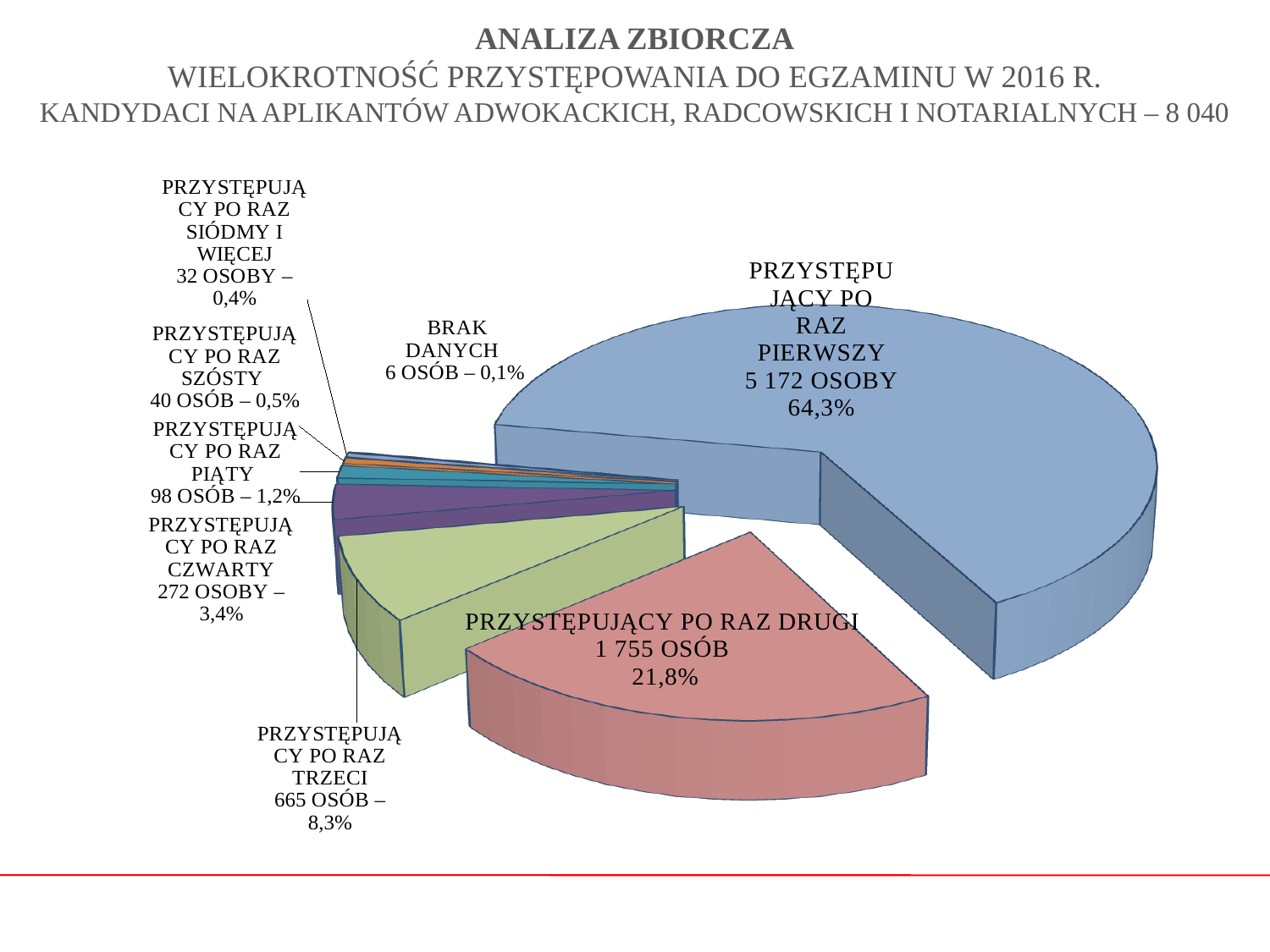
What share of the pie does 'PRZYSTĘPUJĄCY PO RAZ DRUGI' represent? 21,8% Which category has the largest slice of the pie? PRZYSTĘPUJĄCY PO RAZ PIERWSZY How many people are in the 'PRZYSTĘPUJĄCY PO RAZ SIÓDMY I WIĘCEJ' slice? 32 OSOBY Which is larger: the 'PRZYSTĘPUJĄCY PO RAZ PIĄTY' slice or the 'PRZYSTĘPUJĄCY PO RAZ SZÓSTY' slice? PRZYSTĘPUJĄCY PO RAZ PIĄTY How many people are in the 'PRZYSTĘPUJĄCY PO RAZ TRZECI' slice? 665 OSÓB What kind of chart is shown on the slide? pie chart What total number of candidates is given in the slide title? 8 040 How many people are in the 'PRZYSTĘPUJĄCY PO RAZ PIERWSZY' slice? 5 172 OSOBY What percentage is shown for 'PRZYSTĘPUJĄCY PO RAZ CZWARTY'? 3,4% How many slices does the pie chart have? 8 Which category has the smallest slice of the pie? BRAK DANYCH What is the difference in number of people between 'PRZYSTĘPUJĄCY PO RAZ PIERWSZY' and 'PRZYSTĘPUJĄCY PO RAZ DRUGI'? 3 417